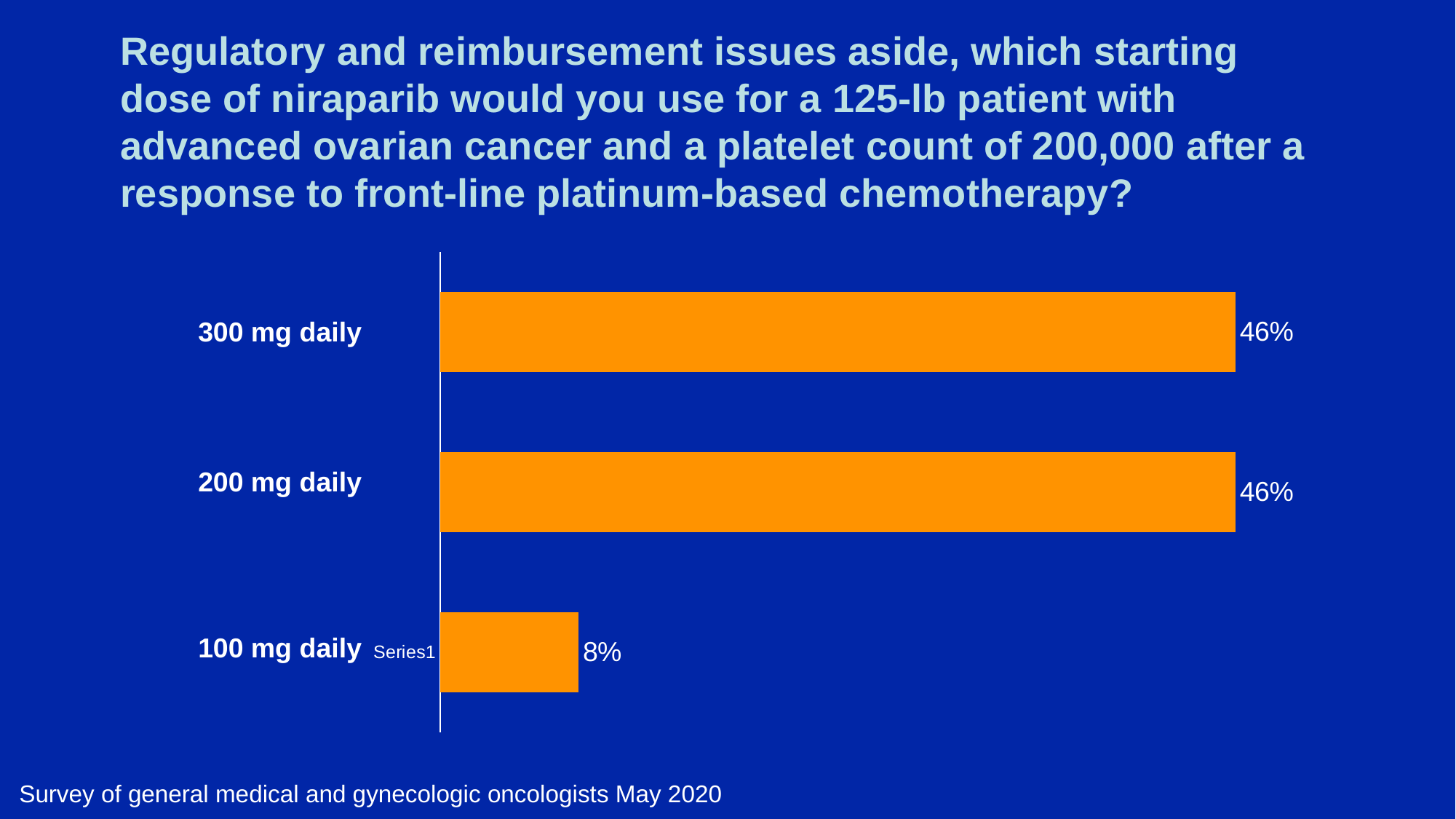
What type of chart is shown on the slide? Bar chart Do the 300 mg daily and 200 mg daily options have the same percentage? Yes, both 46% What percentage of respondents chose 200 mg daily? 46% Which starting dose received the lowest share of responses? 100 mg daily What percentage of respondents chose 300 mg daily? 46% Which received a larger share of responses, 200 mg daily or 100 mg daily? 200 mg daily What percentage of respondents chose 100 mg daily? 8% What is the difference in percentage points between the 300 mg daily and 100 mg daily responses? 38 percentage points What colour are the bars in the chart? Orange How many dose options are shown in the chart? 3 According to the footnote, who was surveyed and when? General medical and gynecologic oncologists, May 2020